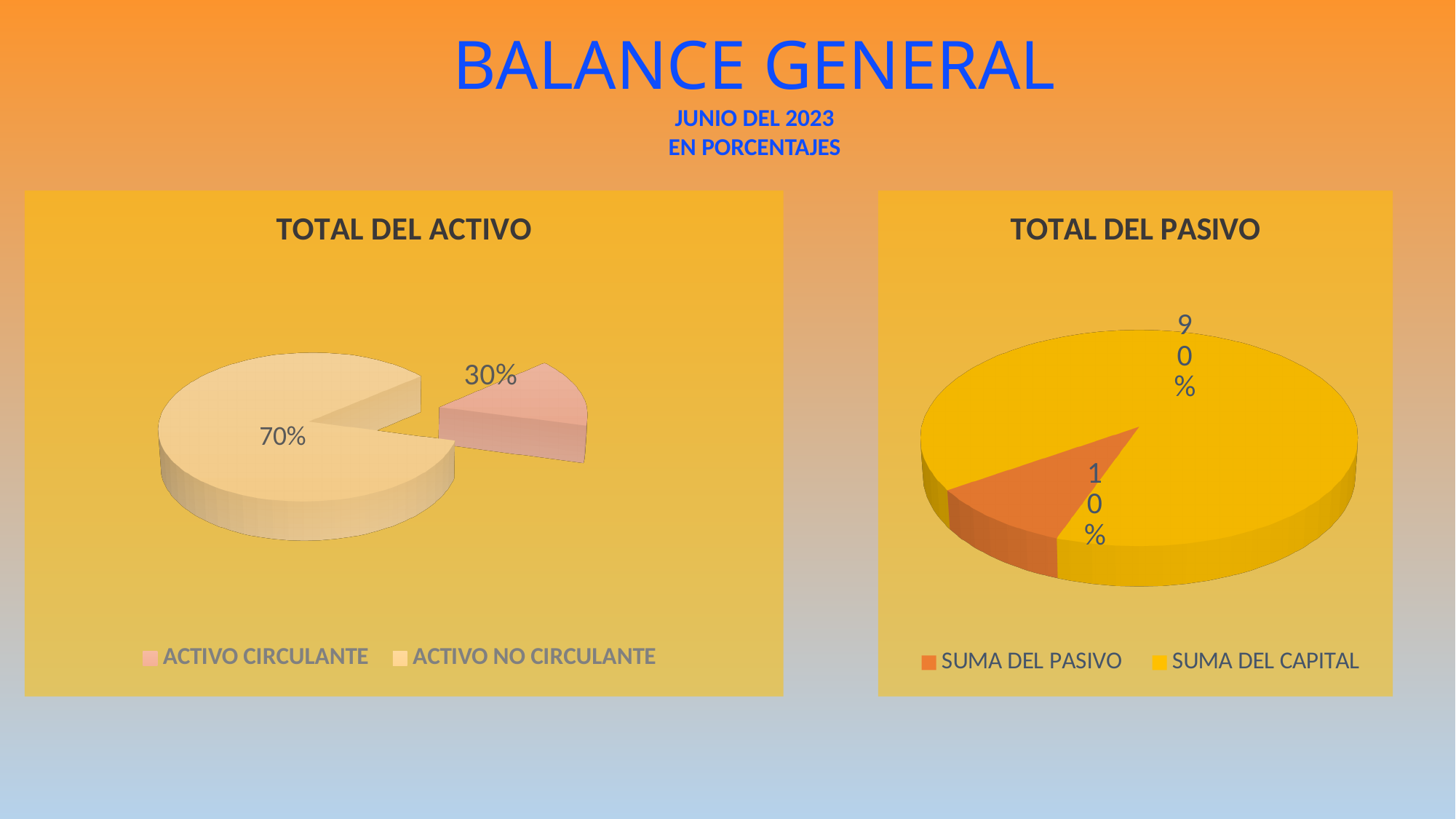
In the 'TOTAL DEL PASIVO' chart, what is the difference in percentage points between SUMA DEL CAPITAL and SUMA DEL PASIVO? 80 In the 'TOTAL DEL PASIVO' chart, what percentage is shown for SUMA DEL CAPITAL? 90% In the 'TOTAL DEL PASIVO' chart, which slice is the smallest? SUMA DEL PASIVO In the 'TOTAL DEL ACTIVO' chart, what colour is the ACTIVO CIRCULANTE slice? Pink In the 'TOTAL DEL PASIVO' chart, which is larger, SUMA DEL PASIVO or SUMA DEL CAPITAL? SUMA DEL CAPITAL How many slices does the 'TOTAL DEL PASIVO' chart have? 2 In the 'TOTAL DEL ACTIVO' chart, what is the difference in percentage points between ACTIVO NO CIRCULANTE and ACTIVO CIRCULANTE? 40 In the 'TOTAL DEL ACTIVO' chart, what percentage is shown for ACTIVO CIRCULANTE? 30% In the 'TOTAL DEL ACTIVO' chart, which slice is the largest? ACTIVO NO CIRCULANTE In the 'TOTAL DEL PASIVO' chart, what percentage is shown for SUMA DEL PASIVO? 10% What type of chart is 'TOTAL DEL ACTIVO'? Pie chart In the 'TOTAL DEL ACTIVO' chart, what percentage is shown for ACTIVO NO CIRCULANTE? 70%